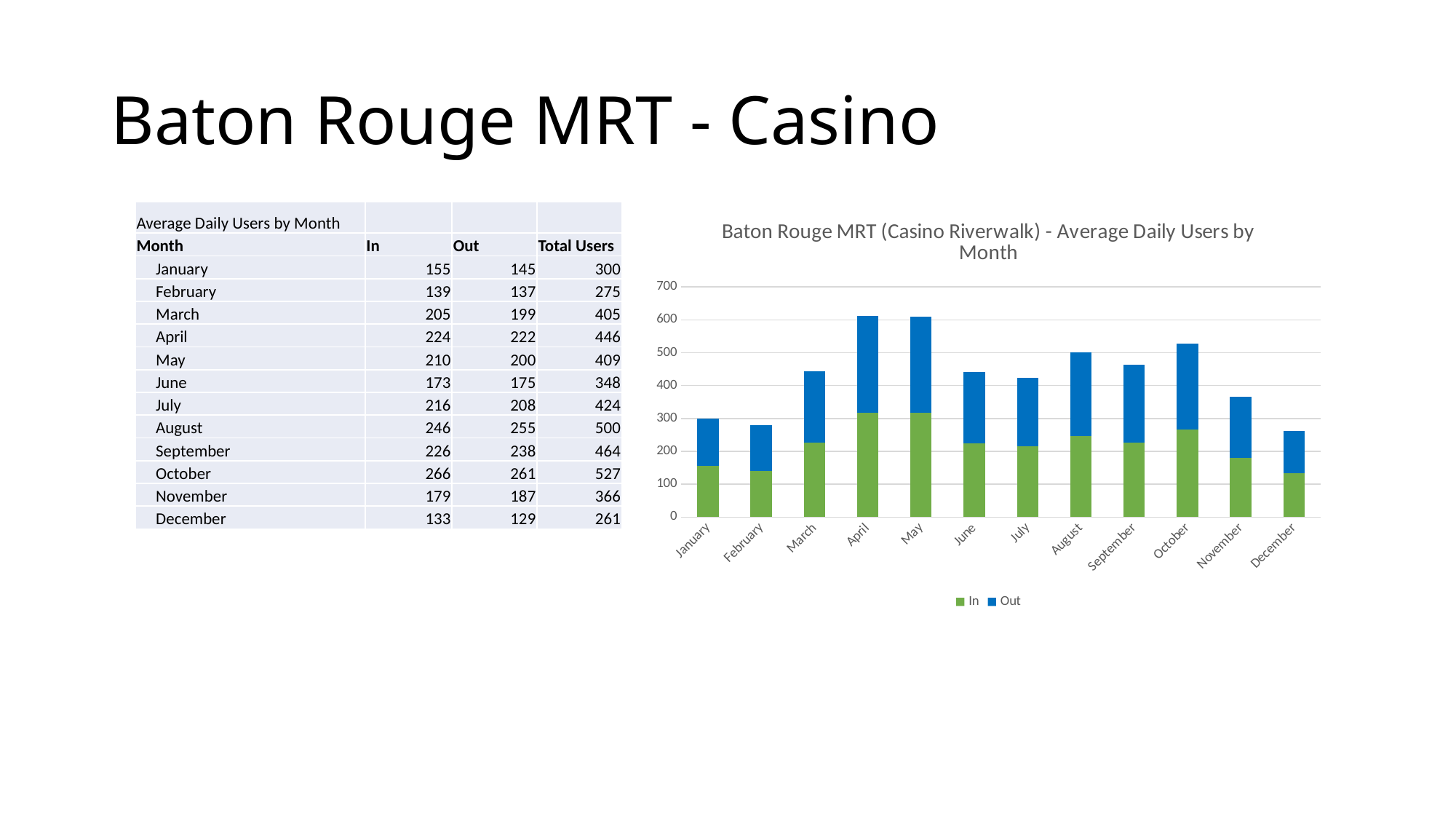
What are the two series named in the chart's legend? In and Out Is the total bar height for April greater or less than 500? greater How many series does the chart's legend list? 2 Do the total bar heights rise or fall from October to December? fall Which month has the taller total bar, October or September? October How many months are plotted on the x axis of the chart? 12 Is the total bar height for November greater or less than 400? less Is the In value for January greater or less than 200? less What is the title of the chart? Baton Rouge MRT (Casino Riverwalk) - Average Daily Users by Month Which month has the taller total bar, April or January? April What kind of chart is shown on the slide? Stacked bar chart